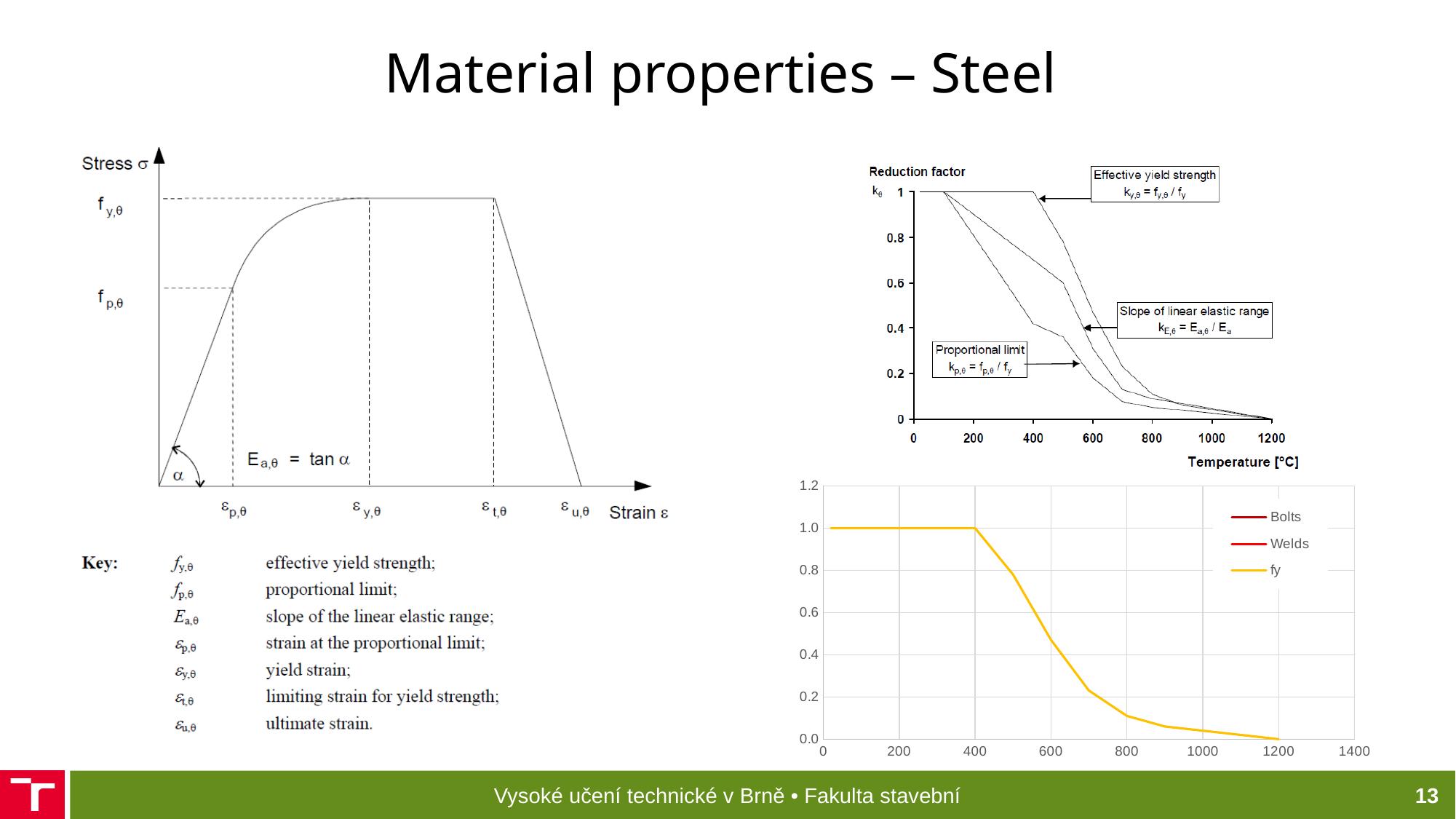
In the top-right 'Reduction factor' chart, is the value of the effective yield strength curve at 400 greater or less than 0.8? greater How many series does the legend of the bottom-right chart list? 3 In the bottom-right chart, is the value of the fy series at 800 greater or less than 0.2? less In the bottom-right chart, does the fy series rise or fall as temperature increases beyond 400? fall In the bottom-right chart, is the value of the fy series at 500 greater or less than 0.6? less In the bottom-right chart, what is the value of the fy series at a temperature of 1200? 0.0 What type of chart is the bottom-right chart on the slide? line chart In the bottom-right chart, what is the value of the fy series at a temperature of 200? 1.0 In the bottom-right chart, which series is drawn in yellow? fy In the top-right 'Reduction factor' chart, what is the x-axis title? Temperature [°C]